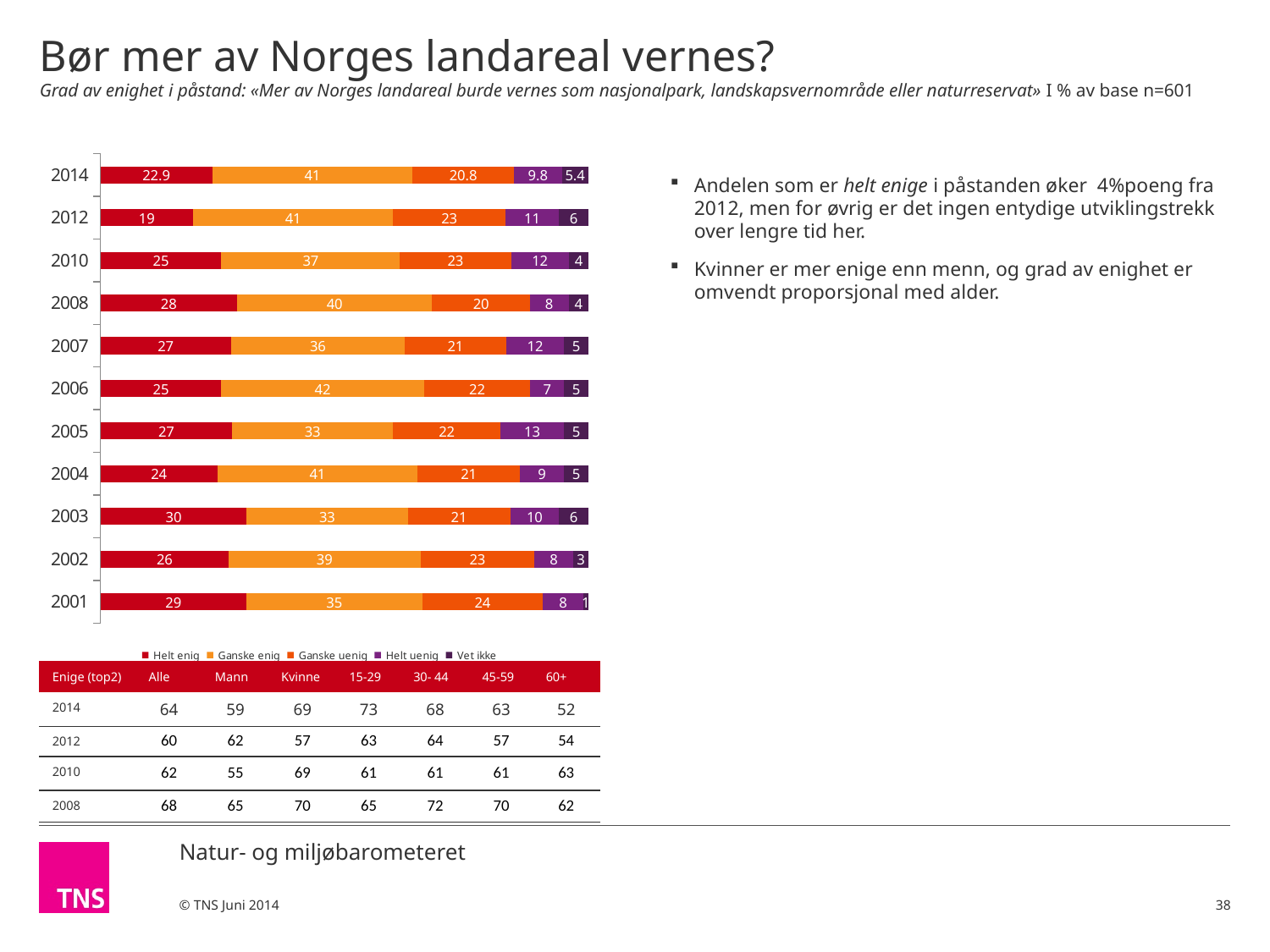
Which is larger, the "Ganske enig" value for 2008 or for 2010? 2008 What is the difference between the "Helt enig" values for 2014 and 2012? 3.9 What kind of chart is shown on the slide? Stacked bar chart What is the value for "Ganske uenig" in 2012? 23 How many years are shown in the chart? 11 What is the value for "Helt enig" in 2014? 22.9 What is the total of the stacked bar for 2012? 100 Which year has the highest value for "Helt enig"? 2003 Which year has the highest value for "Ganske enig"? 2006 Which year has the lowest value for "Helt enig"? 2012 How many series does the legend list? 5 What is the value for "Vet ikke" in 2001? 1